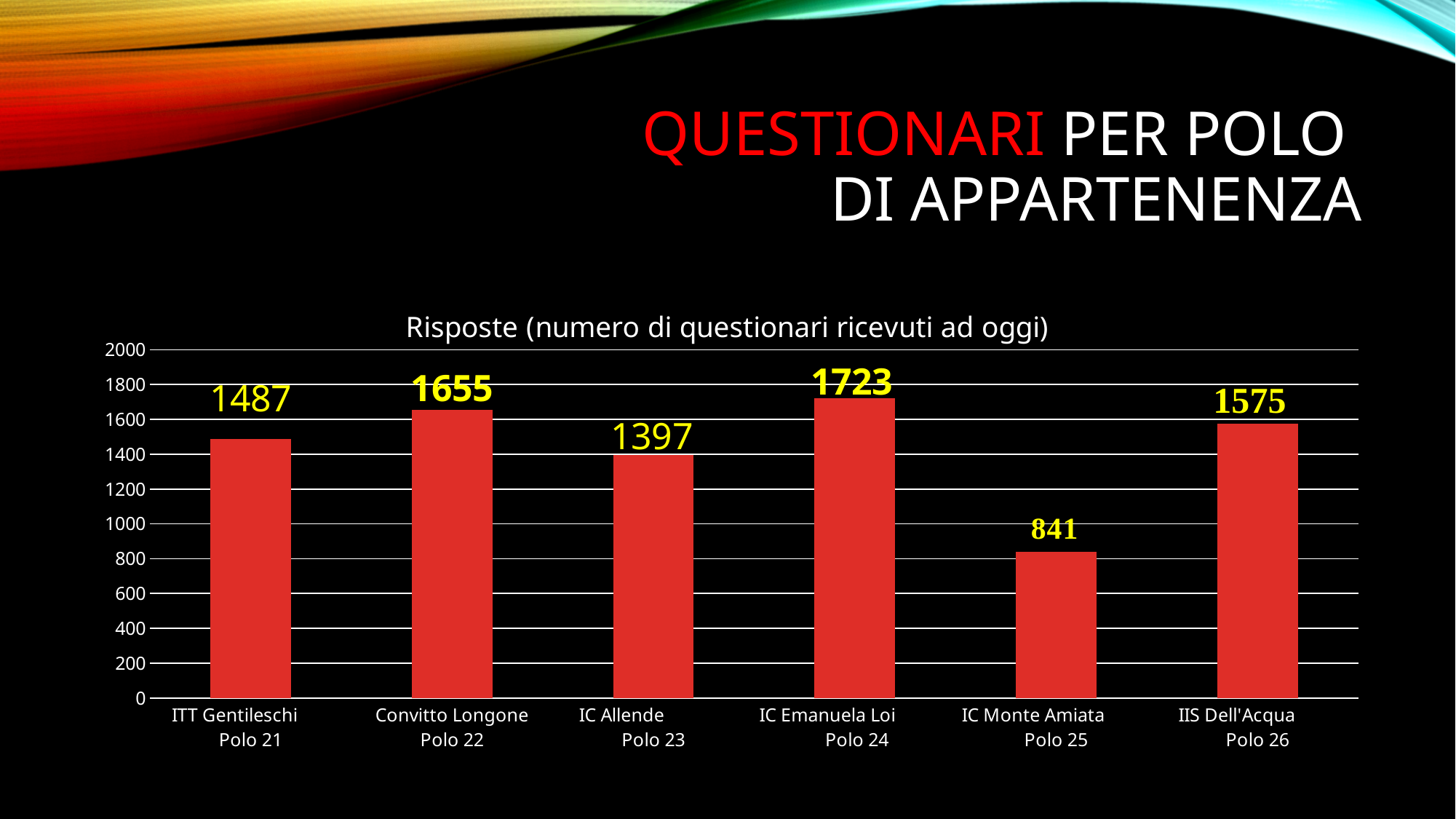
What is the value for IC Monte Amiata Polo 25? 841 What is the difference between the values for Convitto Longone Polo 22 and IC Allende Polo 23? 258 How many categories are shown on the x axis? 6 What is the value for ITT Gentileschi Polo 21? 1487 What is the value for IIS Dell'Acqua Polo 26? 1575 What colour are the bars in the chart? red What kind of chart is shown on the slide? bar chart Is the value for IC Allende Polo 23 greater or less than 1400? less What is the title of the chart? Risposte (numero di questionari ricevuti ad oggi) Which is larger, the value for ITT Gentileschi Polo 21 or the value for IIS Dell'Acqua Polo 26? IIS Dell'Acqua Polo 26 Which category has the lowest value? IC Monte Amiata Polo 25 Which category has the highest value? IC Emanuela Loi Polo 24